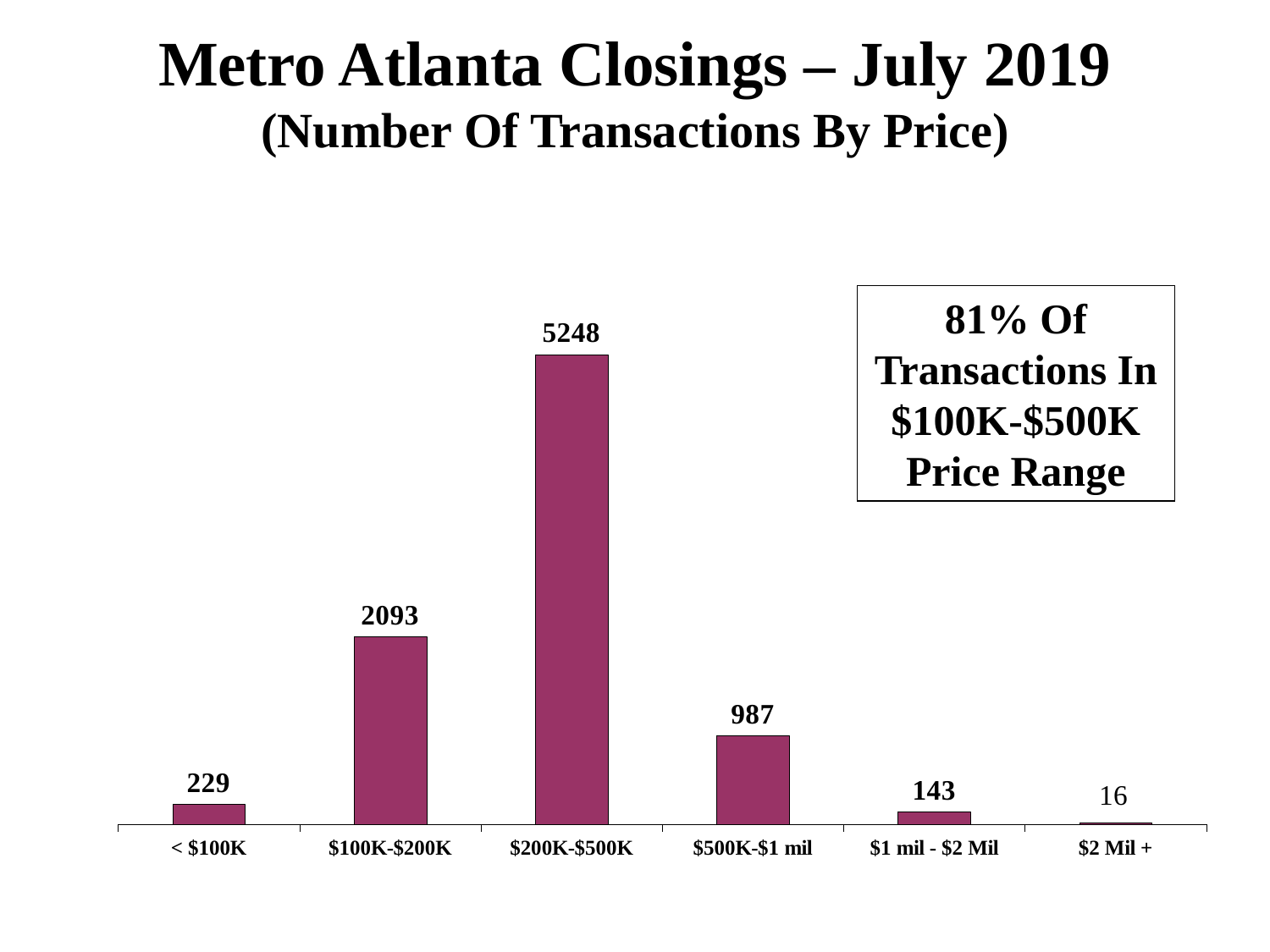
What is the value for the < $100K category? 229 What is the combined number of transactions in the $100K-$200K and $200K-$500K ranges? 7341 What kind of chart is shown on the slide? Bar chart Which has more transactions, < $100K or $1 mil - $2 Mil? < $100K What is the difference between the $100K-$200K and $500K-$1 mil values? 1106 How many price range categories are shown on the chart? 6 Which price range has the highest number of transactions? $200K-$500K How many transactions were in the $200K-$500K price range? 5248 How many transactions were in the $1 mil - $2 Mil range? 143 According to the text box on the slide, what percentage of transactions were in the $100K-$500K price range? 81% Which price range has the lowest number of transactions? $2 Mil + What is the title of the chart? Metro Atlanta Closings – July 2019 (Number Of Transactions By Price)